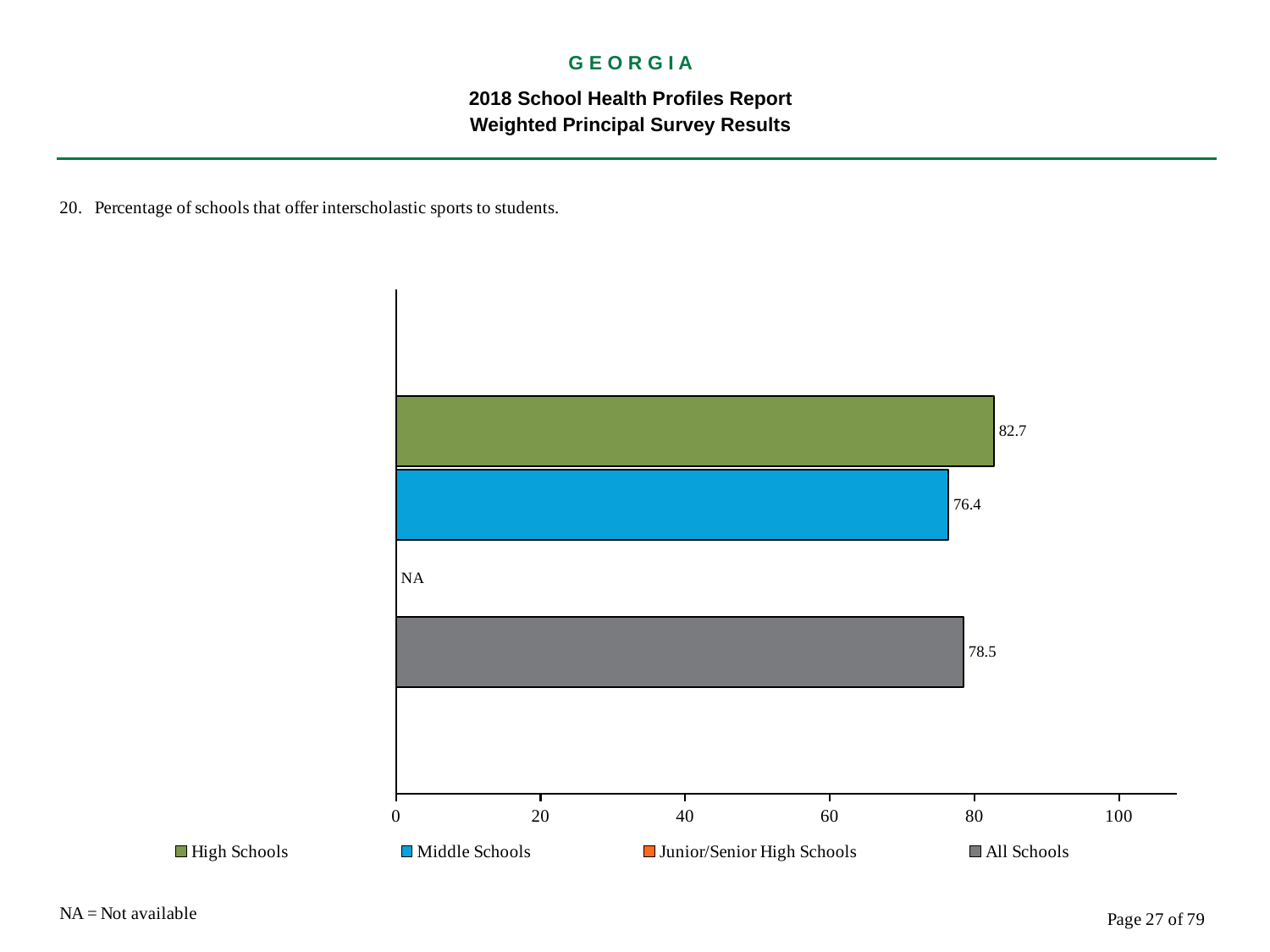
How many series does the legend list? 4 What is the value for High Schools? 82.7 Which school type has the highest value? High Schools What is the difference between the High Schools value and the Middle Schools value? 6.3 What is the value for Middle Schools? 76.4 Among the school types with a plotted value, which has the lowest value? Middle Schools What kind of chart is shown on the slide? bar chart What is shown for Junior/Senior High Schools? NA Which is larger, the value for High Schools or the value for All Schools? High Schools What is the value for All Schools? 78.5 Is the value for Middle Schools greater or less than 80? less What is the difference between the All Schools value and the Middle Schools value? 2.1